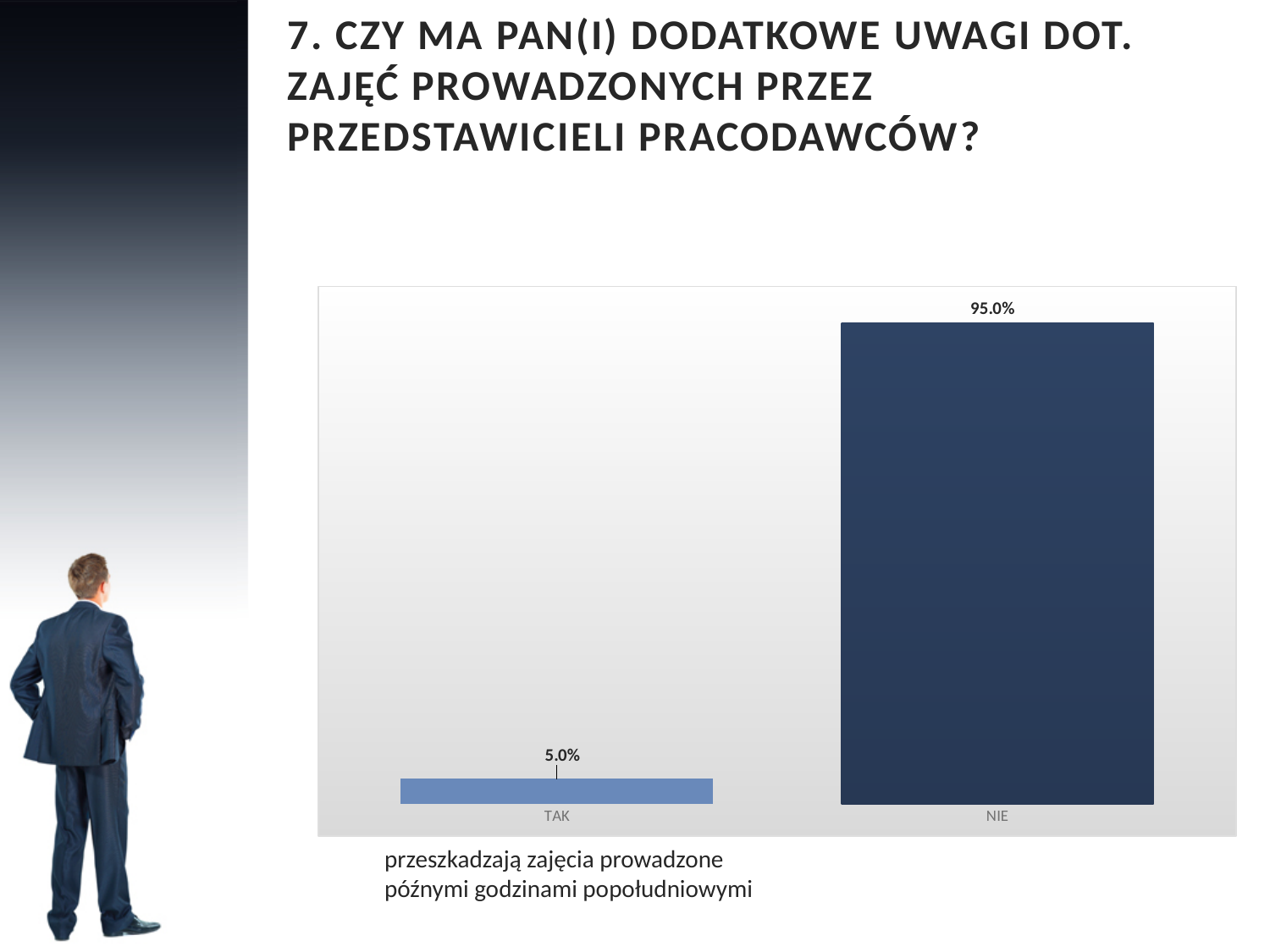
Which is larger, the value for TAK or the value for NIE? NIE What is the value for NIE? 95.0% What is the total of the values for TAK and NIE? 100.0% Which category has the lowest value? TAK What kind of chart is shown on the slide? Bar chart How many categories are shown in the chart? 2 Which category has the highest value? NIE What is the value for TAK? 5.0% What text appears below the chart? przeszkadzają zajęcia prowadzone późnymi godzinami popołudniowymi What is the difference between the values for NIE and TAK? 90.0% What colour is the bar for NIE? Dark blue